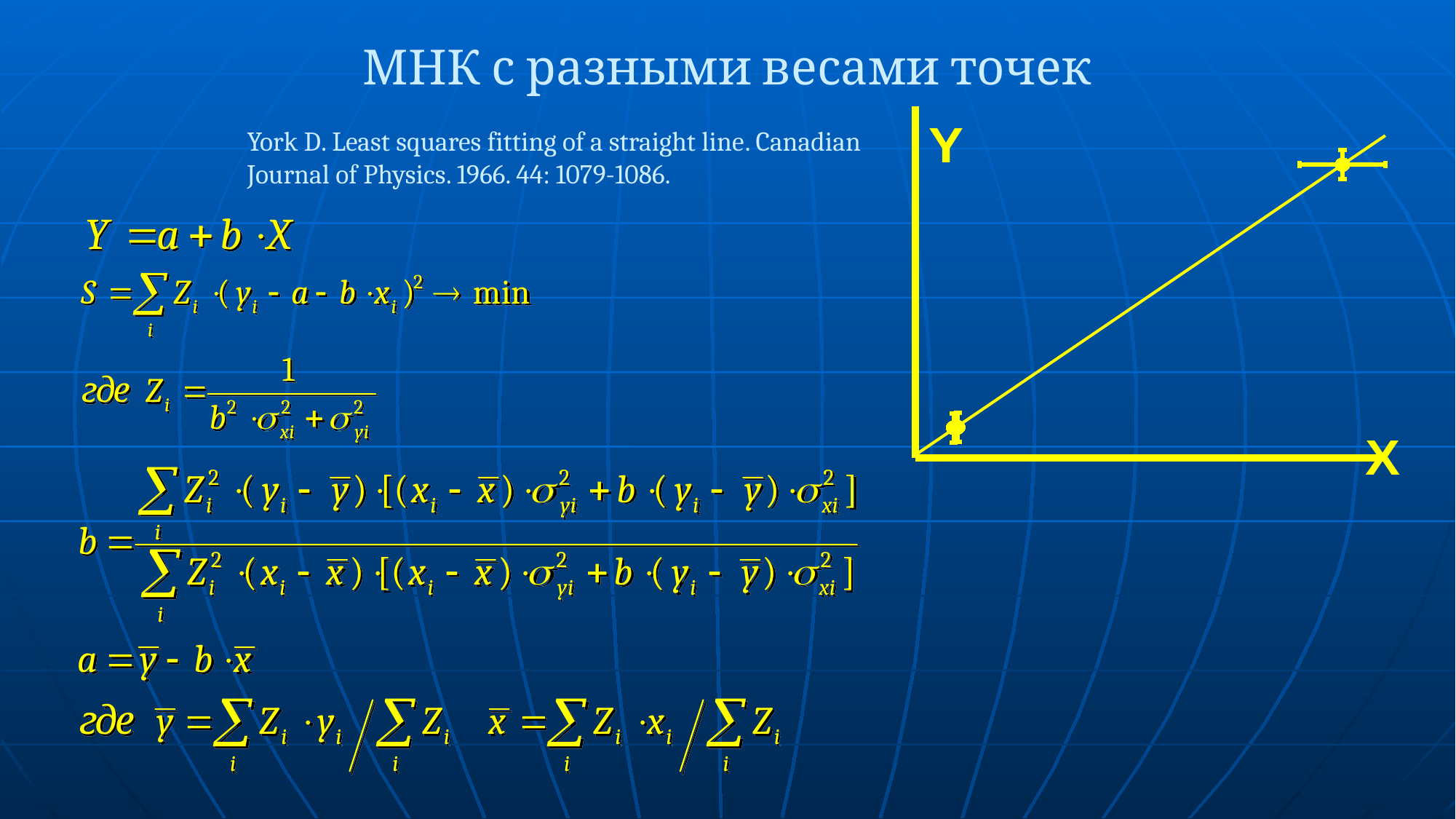
What is the label of the horizontal axis in the diagram on the right? X In the diagram on the right, does the fitted straight line rise or fall as X increases? rise In the diagram on the right, which of the two plotted points has the larger error bars? the upper-right point What is the label of the vertical axis in the diagram on the right? Y